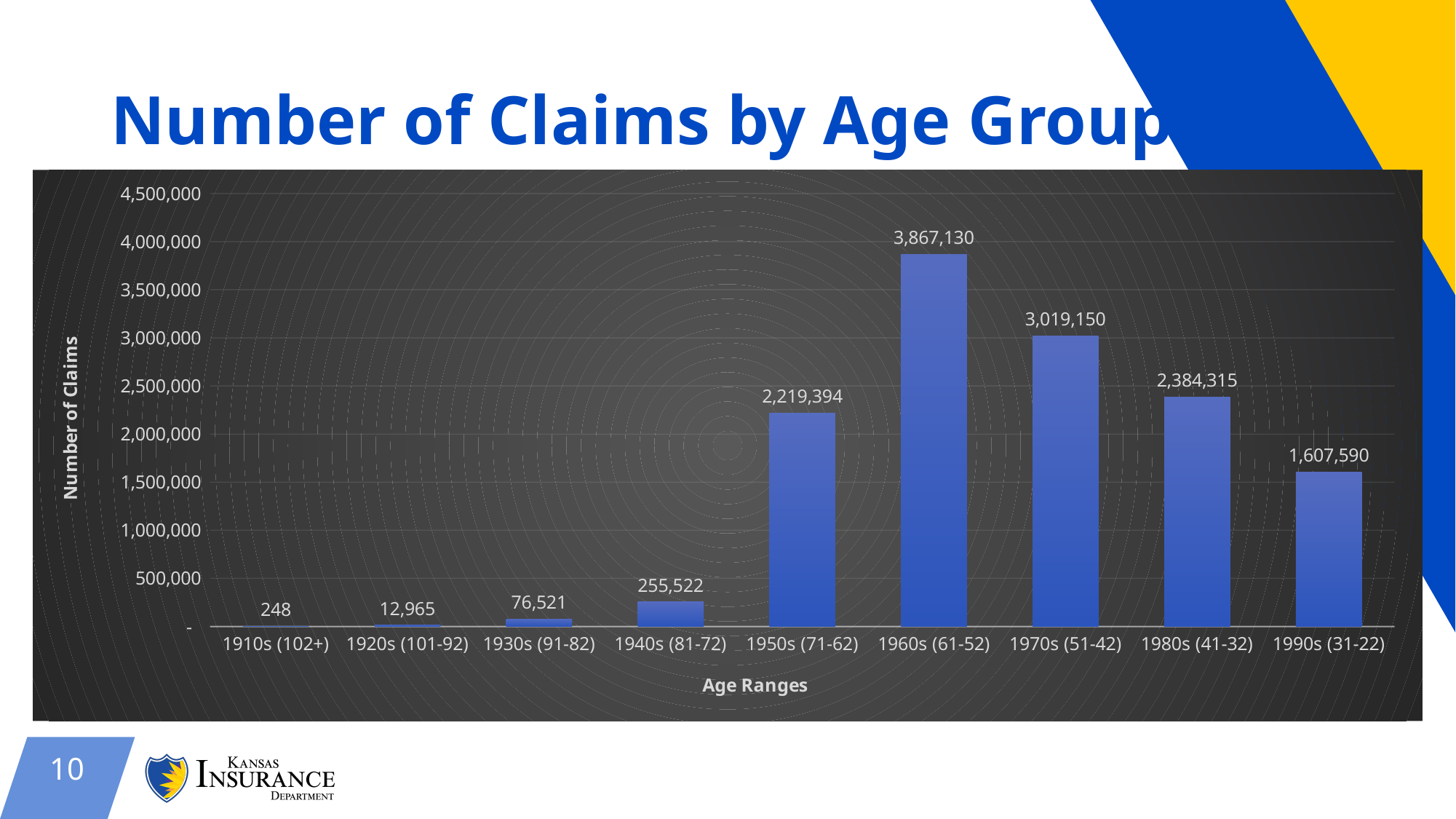
Which age group has the highest number of claims? 1960s (61-52) What is the difference in number of claims between the 1980s (41-32) and 1990s (31-22) age groups? 776,725 What is the difference in number of claims between the 1960s (61-52) and 1970s (51-42) age groups? 847,980 Which age group has more claims, 1950s (71-62) or 1980s (41-32)? 1980s (41-32) What type of chart is shown on the slide? Bar chart Is the number of claims for the 1970s (51-42) age group greater or less than 3,000,000? greater What is the number of claims for the 1990s (31-22) age group? 1,607,590 Which age group has the lowest number of claims? 1910s (102+) What is the label of the x axis of the chart? Age Ranges How many age groups are shown on the chart? 9 What is the number of claims for the 1940s (81-72) age group? 255,522 What is the number of claims for the 1960s (61-52) age group? 3,867,130